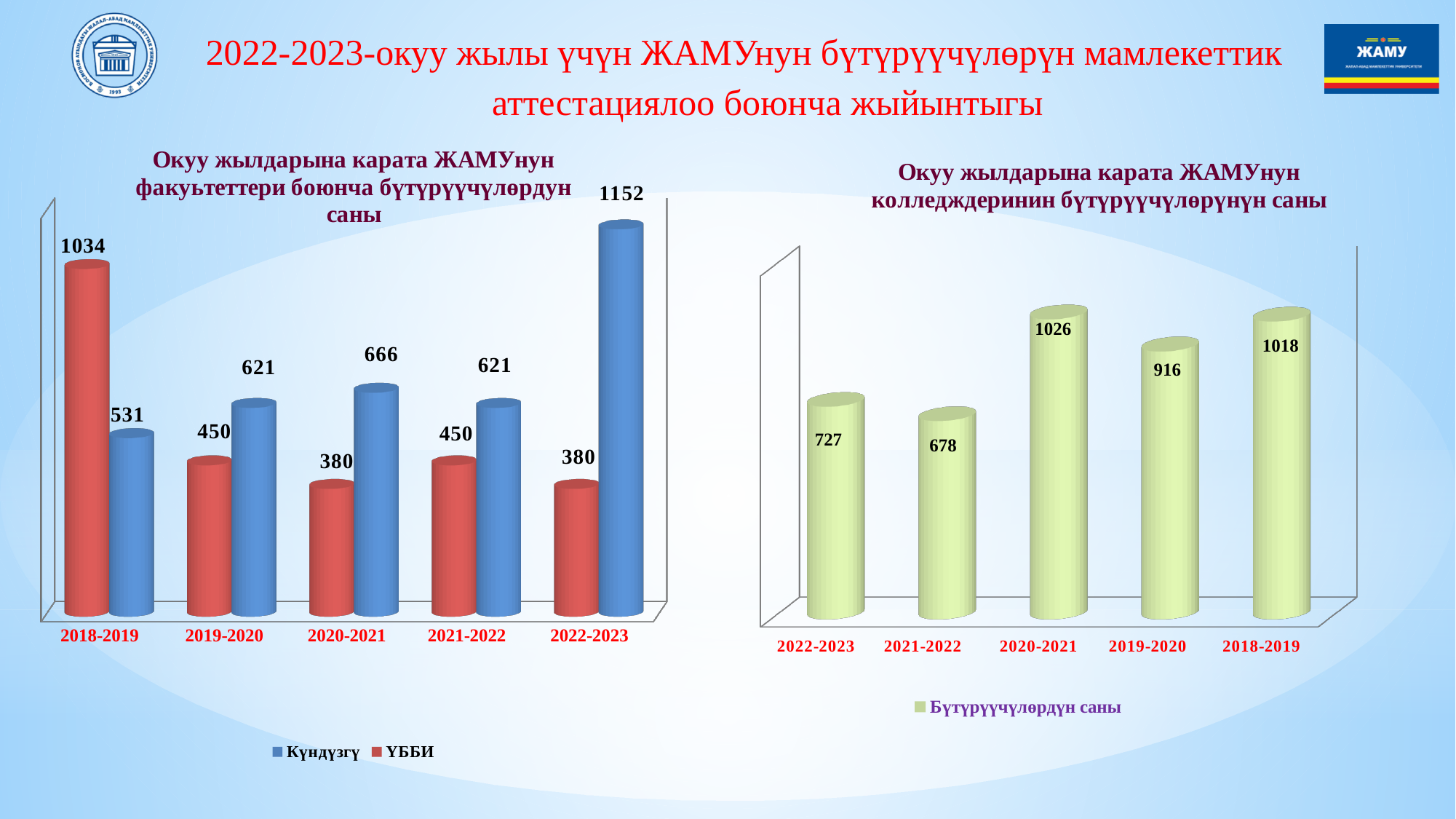
How many academic years are shown on the x axis of the right chart (colleges)? 5 In the left chart (faculties), what is the difference between the Күндүзгү and ҮББИ values for 2022-2023? 772 In the left chart (faculties), which academic year has the lowest Күндүзгү value? 2018-2019 In the right chart (colleges), what is the difference between the values for 2018-2019 and 2022-2023? 291 In the left chart (faculties), what is the Күндүзгү value for 2020-2021? 666 How many series does the legend of the left chart (faculties) list? 2 What type of chart is the right chart (colleges)? Bar chart In the right chart (colleges), which academic year has the lowest value? 2021-2022 In the left chart (faculties), what is the Күндүзгү value for 2022-2023? 1152 In the right chart (colleges), what is the value for 2020-2021? 1026 In the left chart (faculties), what is the ҮББИ value for 2018-2019? 1034 In the left chart (faculties), which is larger for 2019-2020: Күндүзгү or ҮББИ? Күндүзгү